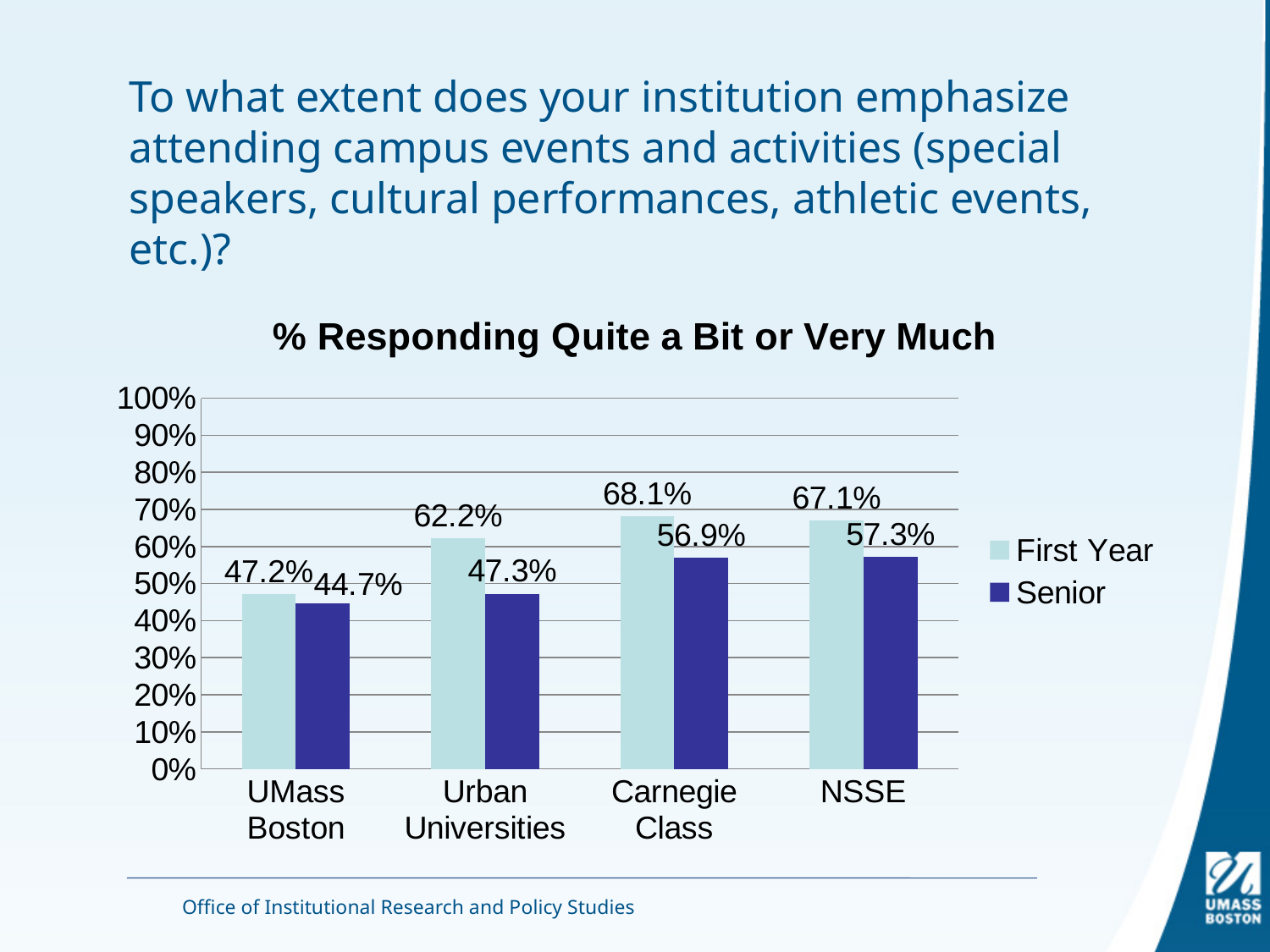
What is the difference between the First Year and Senior values for NSSE? 9.8% How many series does the legend list? 2 Which is larger, the First Year value for Urban Universities or the First Year value for NSSE? NSSE How many categories are shown on the x axis? 4 What is the First Year value for UMass Boston? 47.2% Is the Senior value for UMass Boston greater or less than 50%? less What is the Senior value for Carnegie Class? 56.9% Which category has the highest First Year value? Carnegie Class Which category has the lowest Senior value? UMass Boston What is the Senior value for Urban Universities? 47.3% What is the title of the chart? % Responding Quite a Bit or Very Much What kind of chart is shown? bar chart